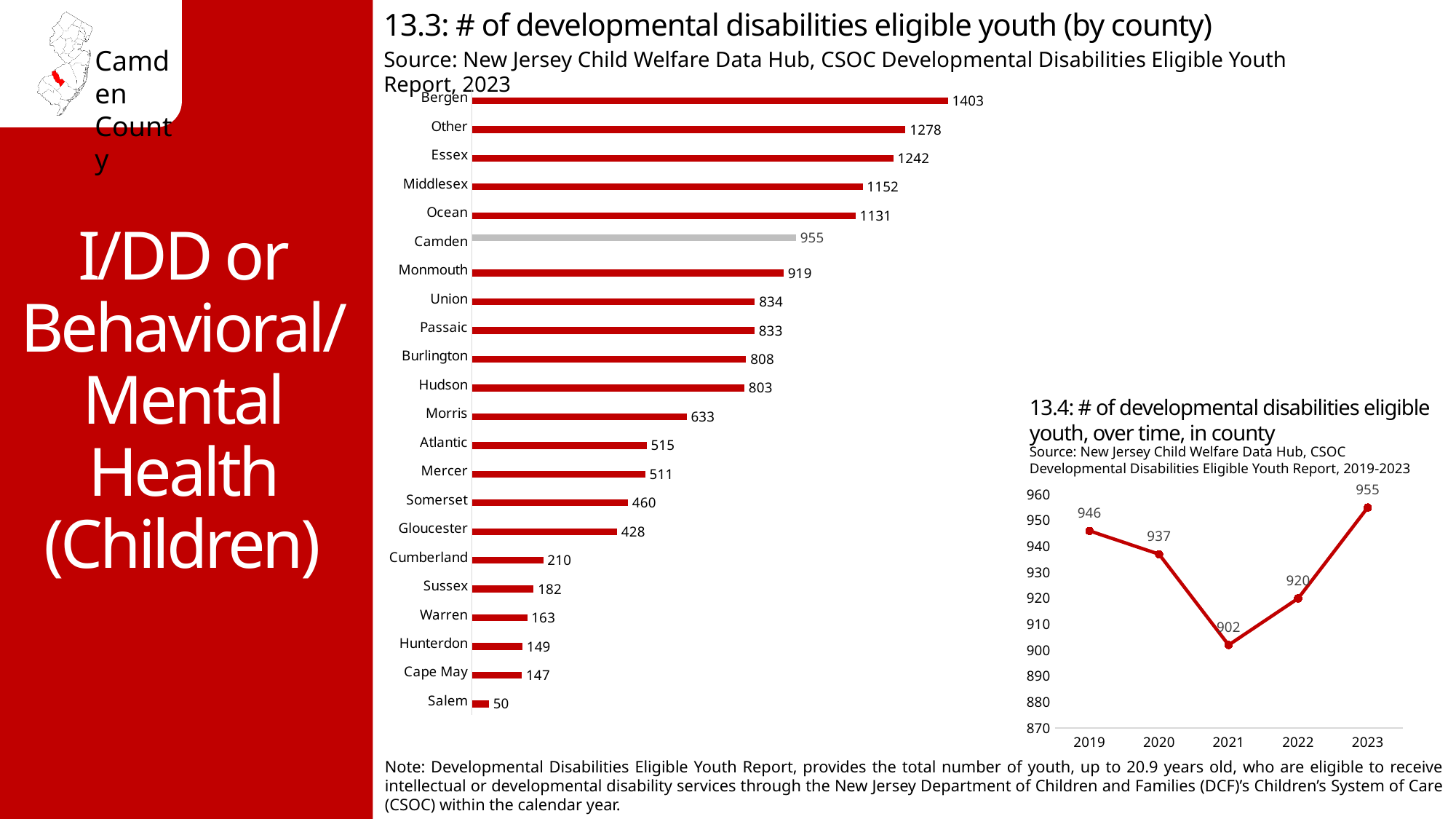
In chart 13.4 (over time, in county), which year has the highest value? 2023 In chart 13.3 (by county), which county has the highest number of eligible youth? Bergen In chart 13.4 (over time, in county), what is the value for 2021? 902 In chart 13.3 (by county), how many bars are shown? 22 In chart 13.3 (by county), what is the value for Middlesex? 1152 In chart 13.3 (by county), what is the difference between Bergen and Essex? 161 In chart 13.3 (# of developmental disabilities eligible youth by county), what is the value for Camden? 955 What kind of chart is chart 13.3 (by county)? Bar chart In chart 13.4 (over time, in county), what is the difference between 2023 and 2019? 9 In chart 13.3 (by county), which bar is coloured grey instead of red? Camden In chart 13.3 (by county), which is larger, Monmouth or Morris? Monmouth In chart 13.3 (by county), which county has the lowest number of eligible youth? Salem